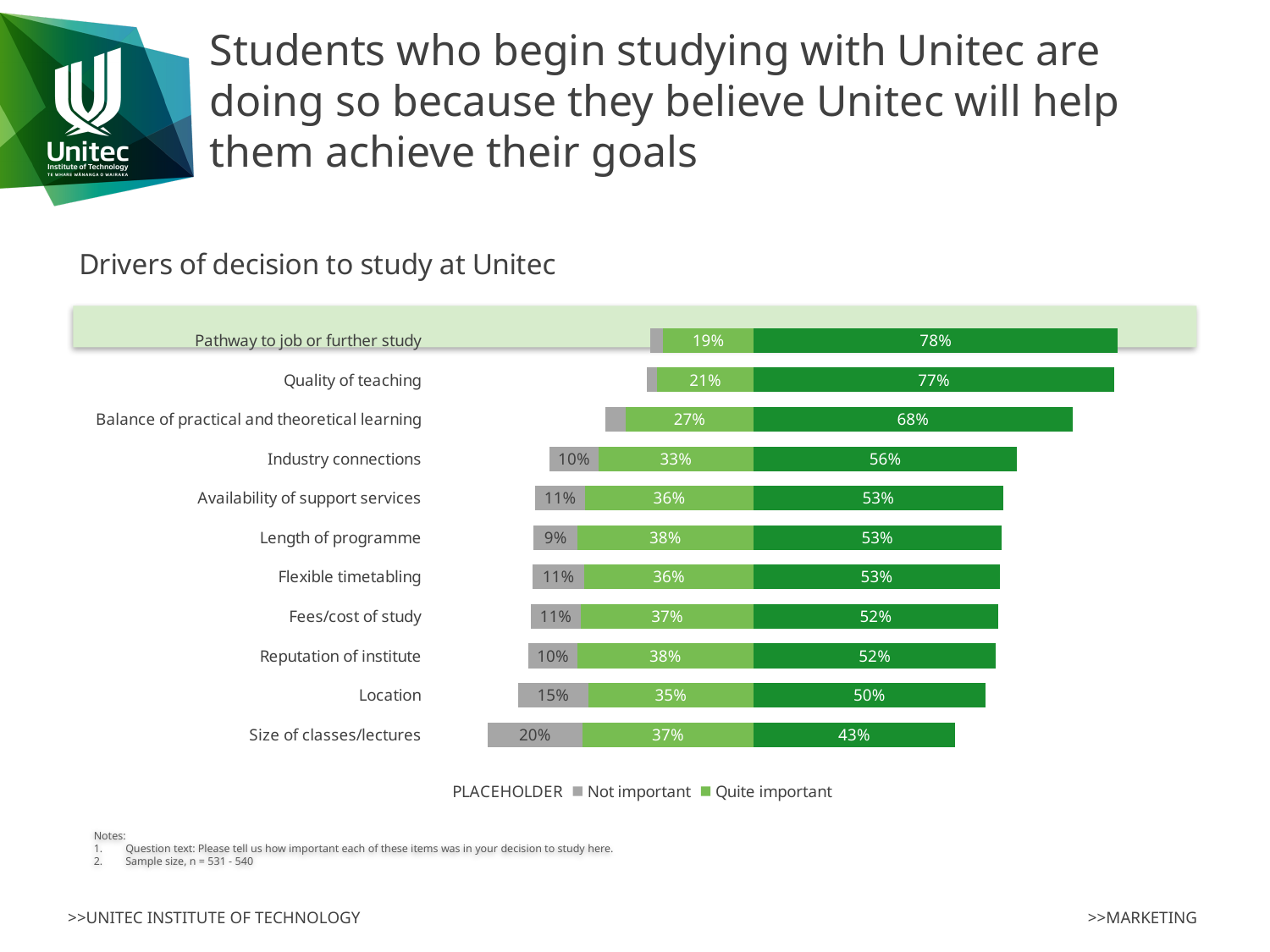
How many drivers (categories) are listed in the chart? 11 Which driver has the highest dark green segment value? Pathway to job or further study What is the total of the three labelled segments for 'Size of classes/lectures'? 100% Which driver has the lowest dark green segment value? Size of classes/lectures How many entries does the chart legend list? 3 What kind of chart is used to show the drivers of decision to study at Unitec? Stacked horizontal bar chart Which has the larger dark green segment value: 'Industry connections' or 'Location'? Industry connections What is the value of the dark green segment for 'Pathway to job or further study'? 78% What is the value of the light green middle segment for 'Balance of practical and theoretical learning'? 27% What is the title of the chart? Drivers of decision to study at Unitec What is the value of the grey segment for 'Size of classes/lectures'? 20% What is the difference between the dark green values for 'Pathway to job or further study' and 'Size of classes/lectures'? 35 percentage points